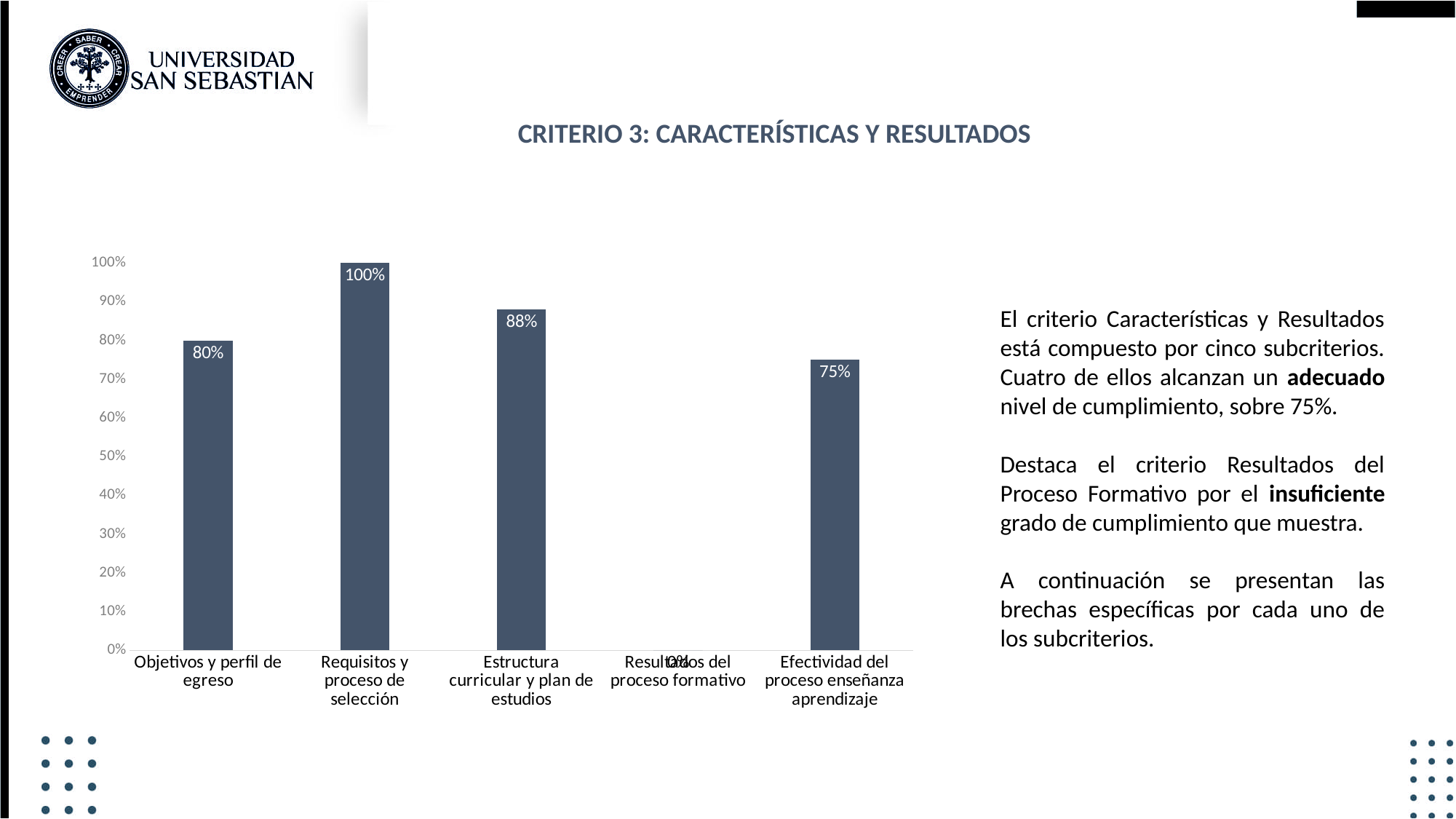
What is the title shown above the chart on the slide? CRITERIO 3: CARACTERÍSTICAS Y RESULTADOS What is the difference between the values for Requisitos y proceso de selección and Objetivos y perfil de egreso? 20% Which category has the highest value? Requisitos y proceso de selección Which category has the lowest value? Resultados del proceso formativo What is the value for Objetivos y perfil de egreso? 80% How many categories are shown on the x axis of the chart? 5 Which is larger, the value for Estructura curricular y plan de estudios or the value for Efectividad del proceso enseñanza aprendizaje? Estructura curricular y plan de estudios What is the value for Requisitos y proceso de selección? 100% What kind of chart is shown on the slide? Bar chart What is the value for Efectividad del proceso enseñanza aprendizaje? 75% What is the value for Resultados del proceso formativo? 0% What is the value for Estructura curricular y plan de estudios? 88%